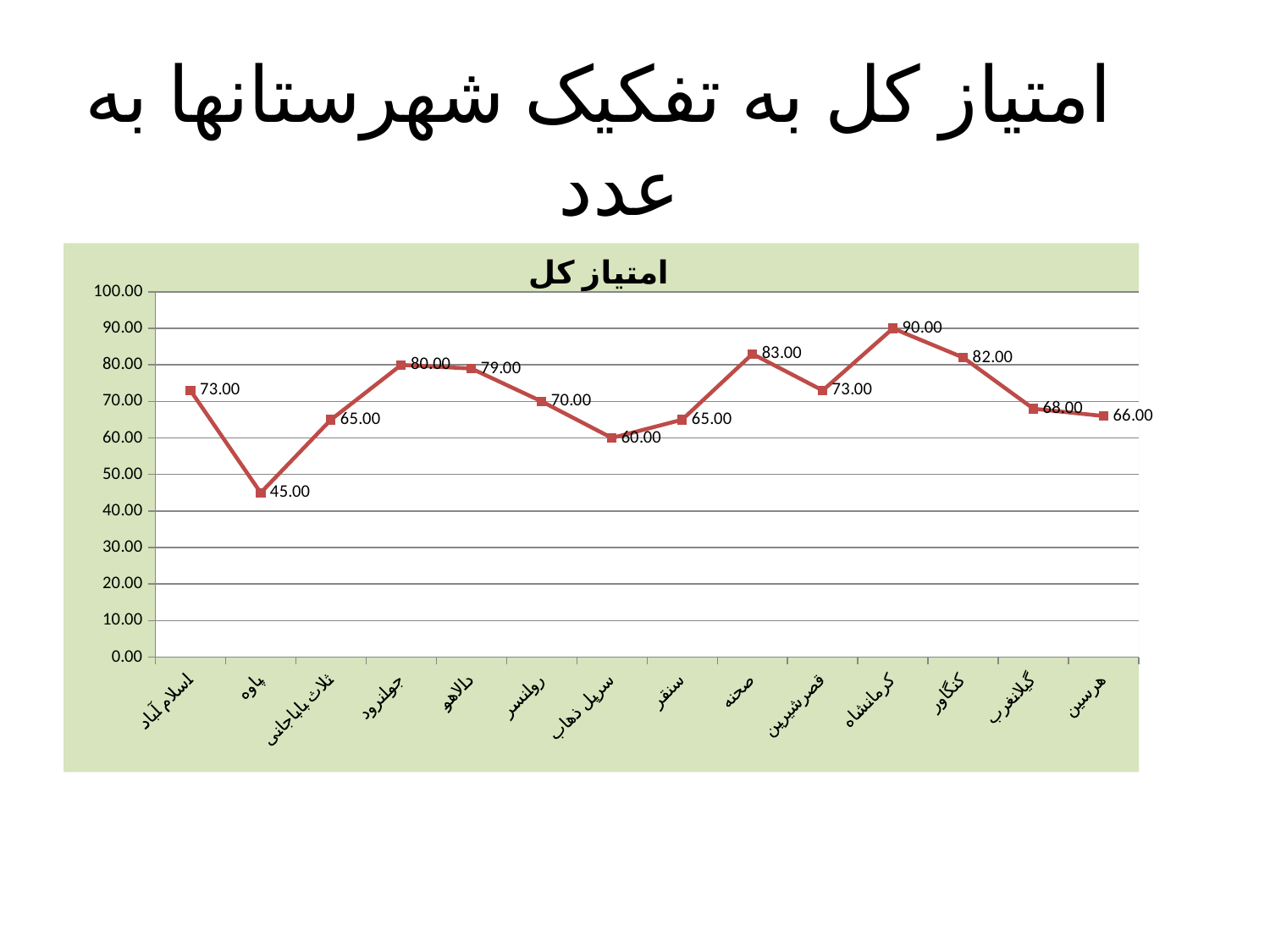
How many categories are plotted on the x axis? 14 Which category has the highest value? کرمانشاه Which category has the lowest value? پاوه What type of chart is shown on the slide? line chart Which is larger, the value for صحنه or the value for قصرشیرین? صحنه What is the value for کنگاور? 82.00 What is the value for پاوه? 45.00 What is the value for سرپل ذهاب? 60.00 What is the difference between the values for کرمانشاه and پاوه? 45.00 Is the value for جوانرود greater or less than 70.00? greater What is the value for کرمانشاه? 90.00 What is the title of the chart? امتیاز کل